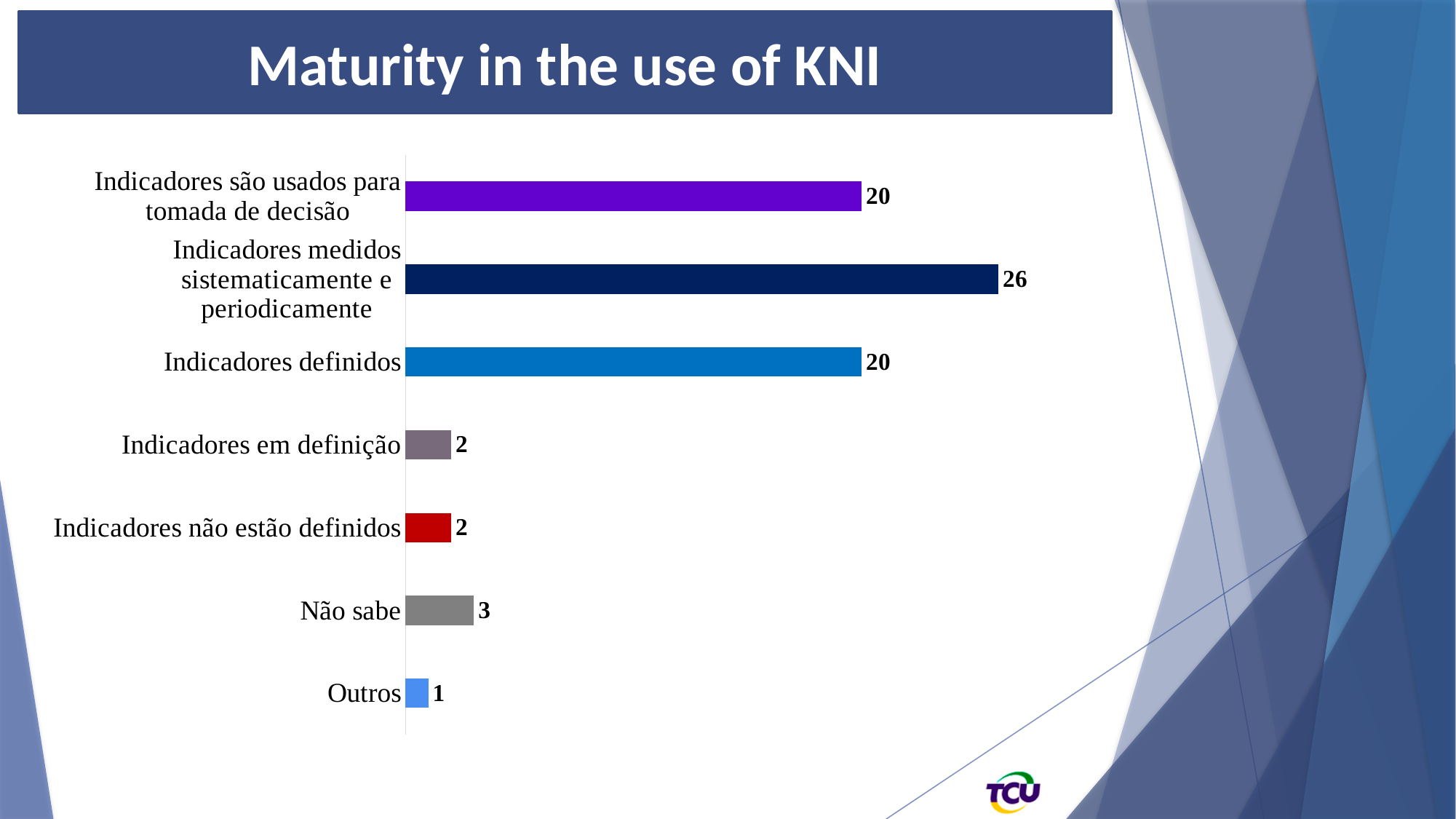
What is the value for "Não sabe"? 3 Which category has the lowest value? Outros Which is larger: the value for "Não sabe" or the value for "Indicadores em definição"? Não sabe What is the difference between the values for "Indicadores medidos sistematicamente e periodicamente" and "Indicadores definidos"? 6 Which category has the highest value? Indicadores medidos sistematicamente e periodicamente What is the title of the slide containing the chart? Maturity in the use of KNI What is the value for "Indicadores medidos sistematicamente e periodicamente"? 26 How many categories are shown in the chart? 7 What is the difference between the values for "Não sabe" and "Outros"? 2 What kind of chart is shown on the slide? Bar chart What is the value for "Indicadores definidos"? 20 What is the value for "Outros"? 1